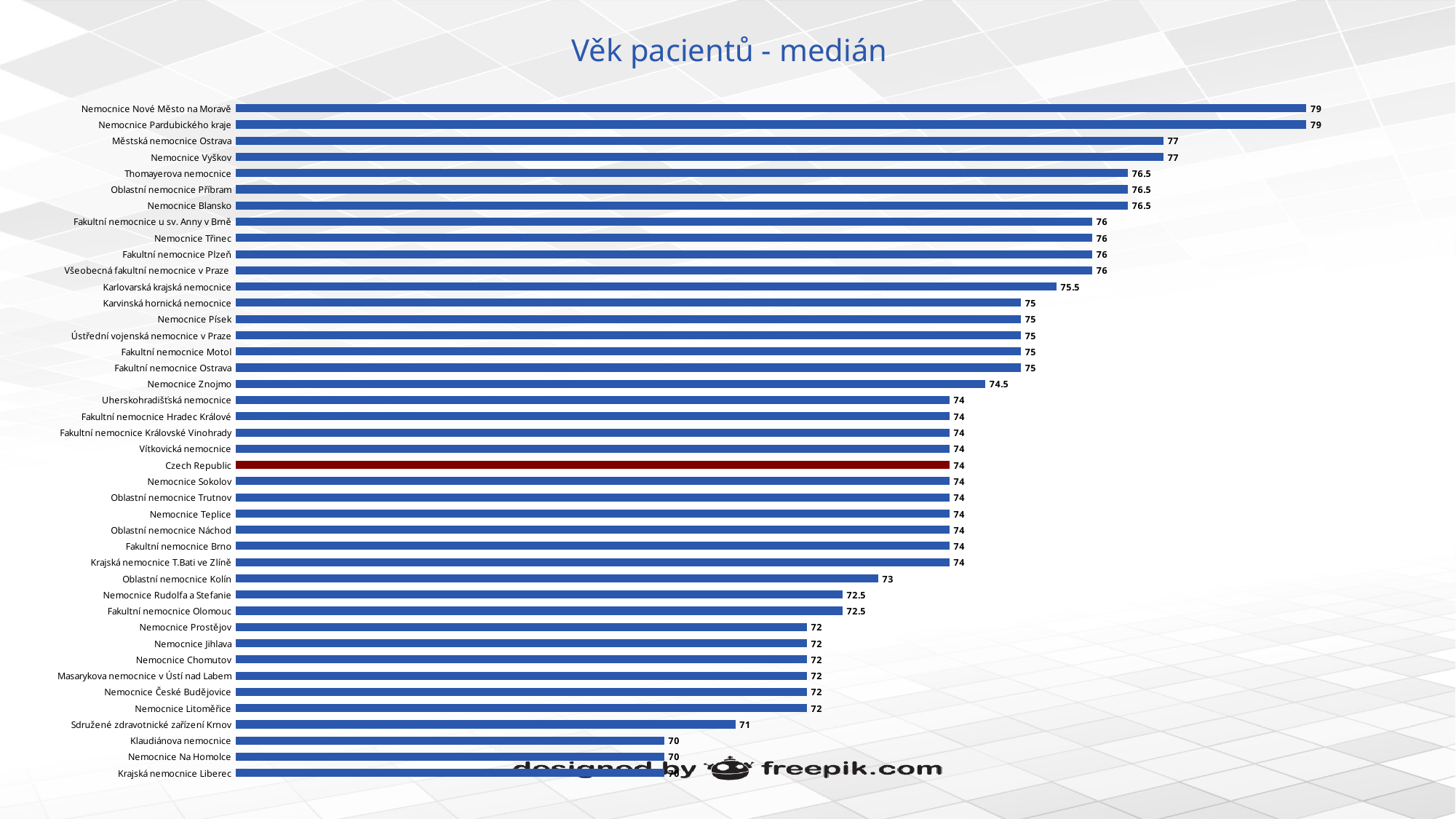
Which bar is shown in a different colour (dark red) from the others? Czech Republic What is the median patient age for Karlovarská krajská nemocnice? 75.5 What is the median patient age for Thomayerova nemocnice? 76.5 Which has a lower median patient age, Nemocnice Na Homolce or Nemocnice Jihlava? Nemocnice Na Homolce What is the difference between the median patient age for Fakultní nemocnice Olomouc and Oblastní nemocnice Kolín? 0.5 What is the median patient age for Czech Republic? 74 Which has a higher median patient age, Městská nemocnice Ostrava or Fakultní nemocnice Motol? Městská nemocnice Ostrava What is the title of the chart? Věk pacientů - medián What is the difference between the median patient age for Nemocnice Nové Město na Moravě and Klaudiánova nemocnice? 9 What is the median patient age for Nemocnice Znojmo? 74.5 What kind of chart is shown on the slide? Bar chart What is the median patient age for Sdružené zdravotnické zařízení Krnov? 71